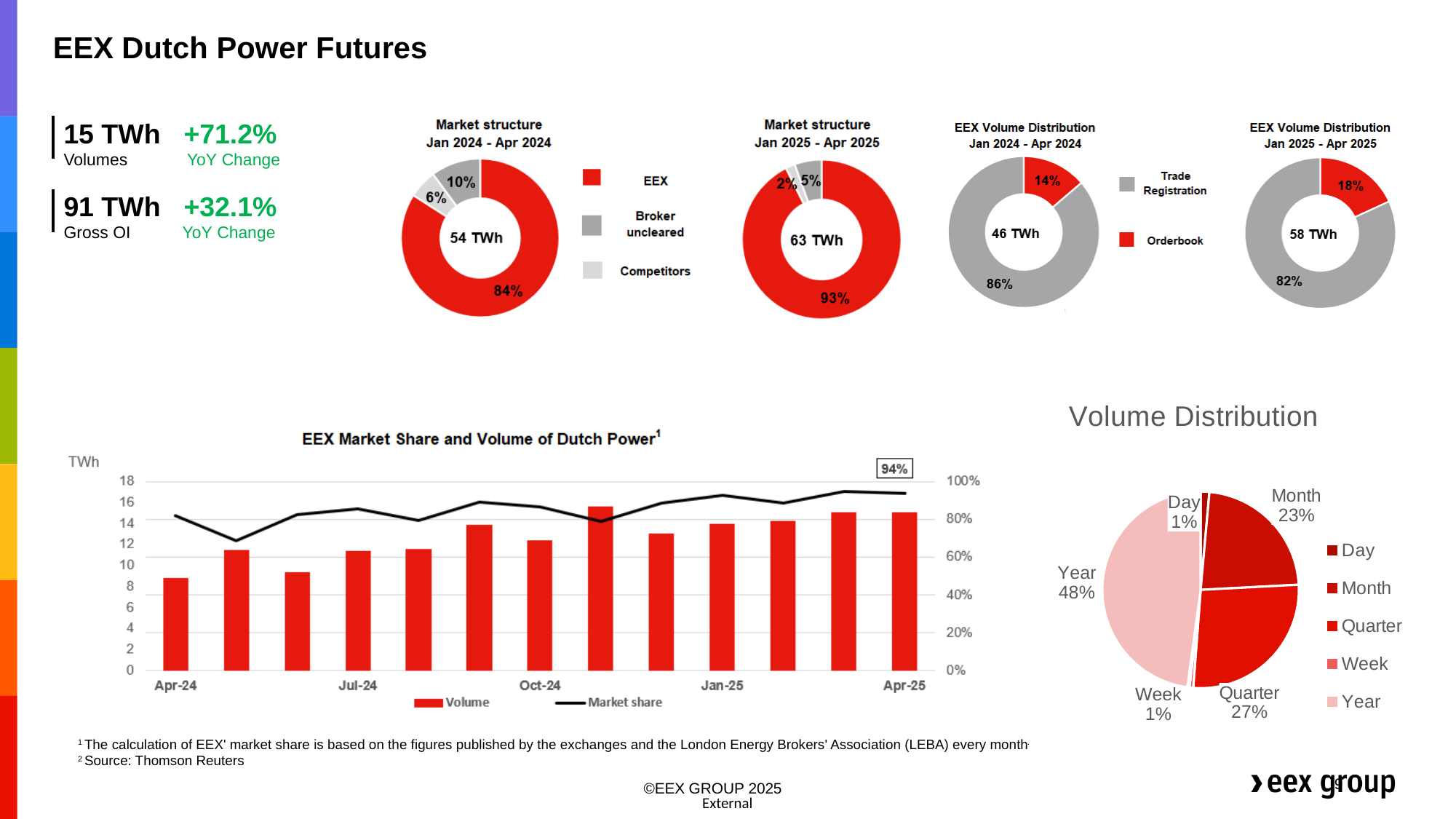
In the EEX Volume Distribution Jan 2024 - Apr 2024 donut chart, what share is Orderbook? 14% Comparing the two Market structure donut charts, by how many percentage points did the Broker uncleared share fall from Jan 2024 - Apr 2024 to Jan 2025 - Apr 2025? 5 percentage points In the Volume Distribution pie chart, which is larger, Month or Quarter? Quarter In the EEX Market Share and Volume of Dutch Power chart, how many series does the legend list? 2 In the Volume Distribution pie chart, how many slices are there? 5 In the Volume Distribution pie chart, which slice is the largest? Year In the Volume Distribution pie chart, what share does Year have? 48% In the EEX Volume Distribution Jan 2025 - Apr 2025 donut chart, what share is Trade Registration? 82% In the Market structure Jan 2025 - Apr 2025 donut chart, what share does EEX hold? 93% In the EEX Market Share and Volume of Dutch Power chart, is the volume bar for Apr-24 greater or less than 10 TWh? less In the Market structure Jan 2024 - Apr 2024 donut chart, what share does EEX hold? 84% In the Market structure Jan 2025 - Apr 2025 donut chart, what total volume is shown in the centre? 63 TWh